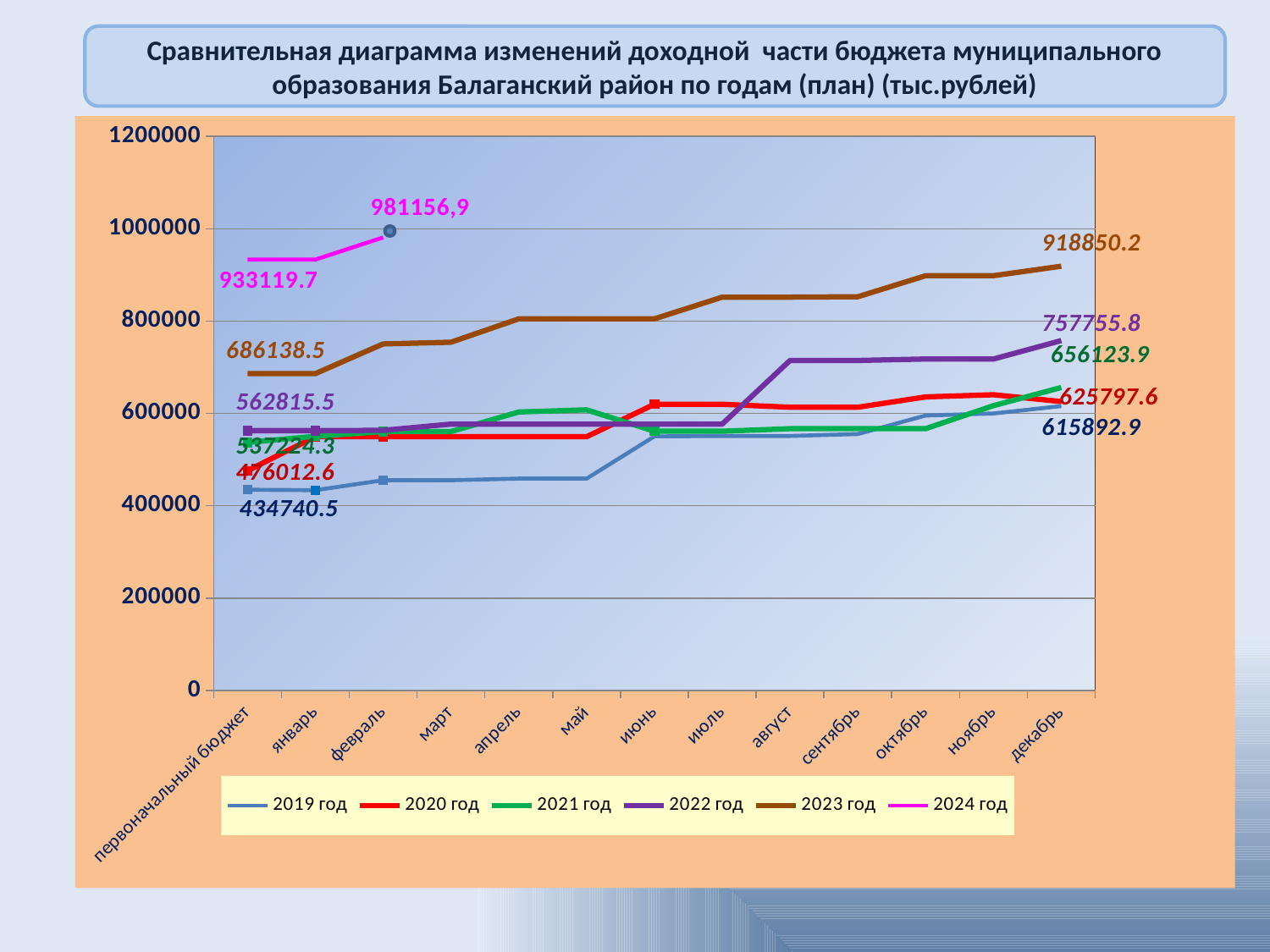
Which series has the larger value in декабрь, 2022 год or 2021 год? 2022 год How many categories are shown along the x axis? 13 What is the value for 2024 год at первоначальный бюджет? 933119.7 Which series has the lowest value at первоначальный бюджет? 2019 год What is the value for 2024 год in февраль? 981156,9 What is the value for 2019 год at первоначальный бюджет? 434740.5 By how much did the 2023 год value in декабрь exceed its value at первоначальный бюджет? 232711.7 Does the 2023 год line generally rise or fall from первоначальный бюджет to декабрь? rise What is the value for 2023 год in декабрь? 918850.2 How many series does the legend list? 6 Is the value for 2019 год in май greater or less than 600000? less What kind of chart is shown on the slide? line chart